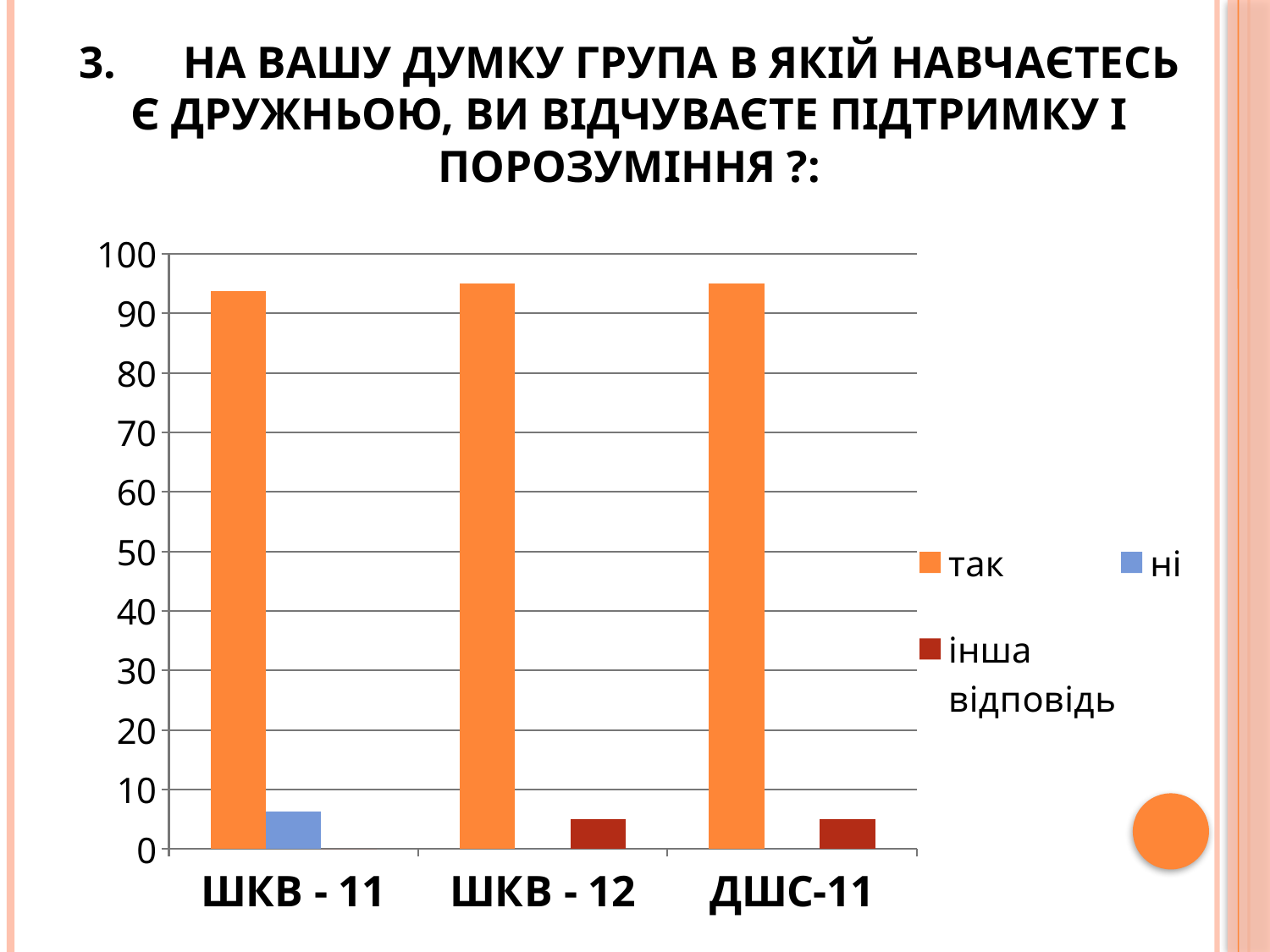
How many series does the chart's legend list? 3 Which is larger for ШКВ - 12: the value for "так" or the value for "інша відповідь"? так Is the value for "так" in ШКВ - 12 greater or less than 90? greater Is the value for "ні" in ШКВ - 11 greater or less than 10? less How many groups (categories) are shown on the x axis of the chart? 3 Which is larger for ШКВ - 11: the value for "так" or the value for "ні"? так What kind of chart is shown on the slide? bar chart Which series is shown in dark red in the chart? інша відповідь Is the value for "так" in ДШС-11 greater or less than 50? greater Which group is the only one with a bar for the "ні" series? ШКВ - 11 Which series is shown in orange in the chart? так